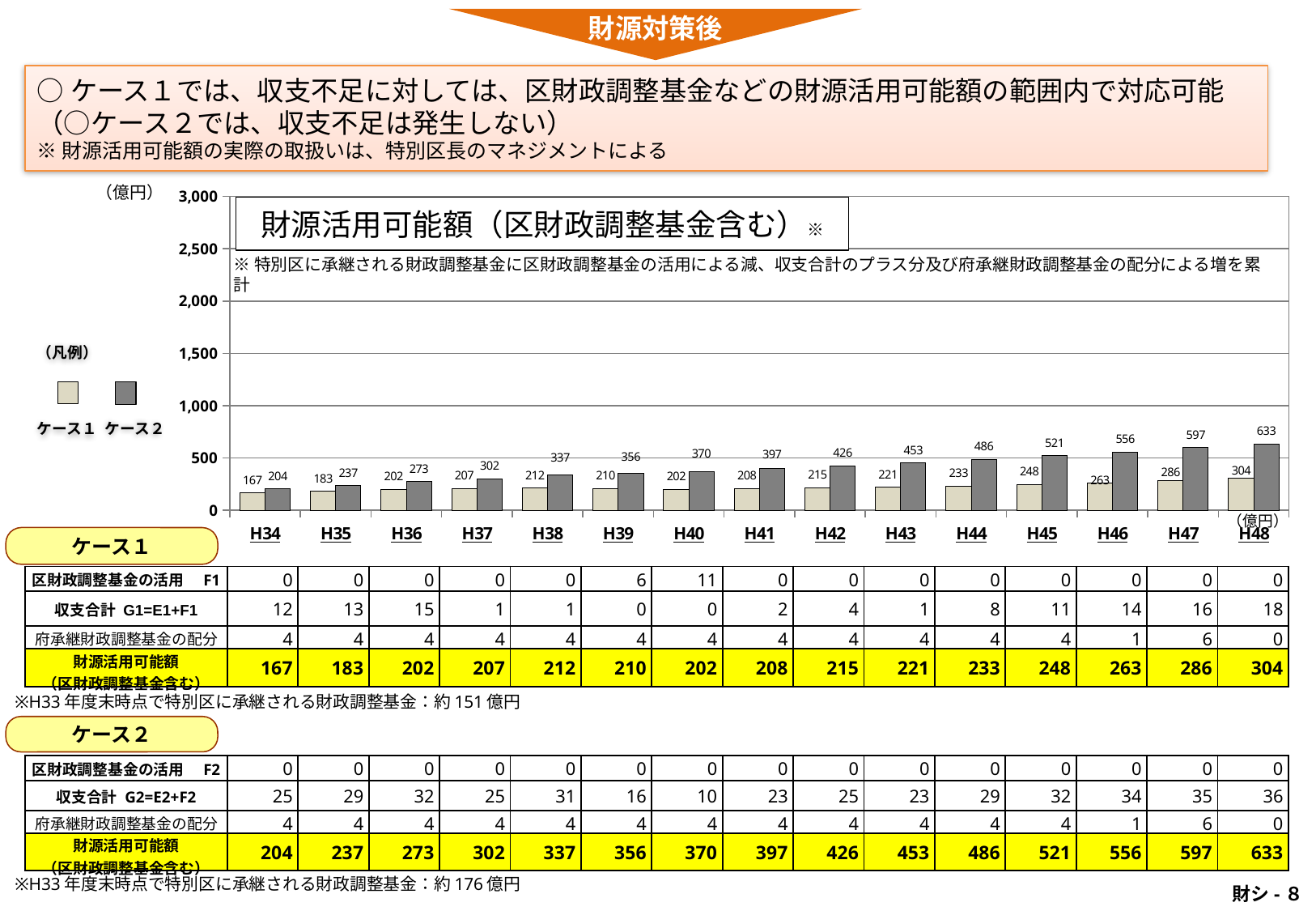
How many series does the legend list? 2 How many years are shown on the x axis of the chart? 15 What is the value for ケース２ in H38? 337 Is the value for ケース２ in H48 greater or less than 500? greater What is the value for ケース２ in H48? 633 Which is larger in H40: the ケース１ value or the ケース２ value? ケース２ What kind of chart is shown on the slide? bar chart What is the difference between ケース２ and ケース１ in H48? 329 What is the difference between the ケース１ values in H48 and H34? 137 In which year is the ケース１ value lowest? H34 What is the value for ケース１ in H45? 248 In which year is the ケース２ value highest? H48